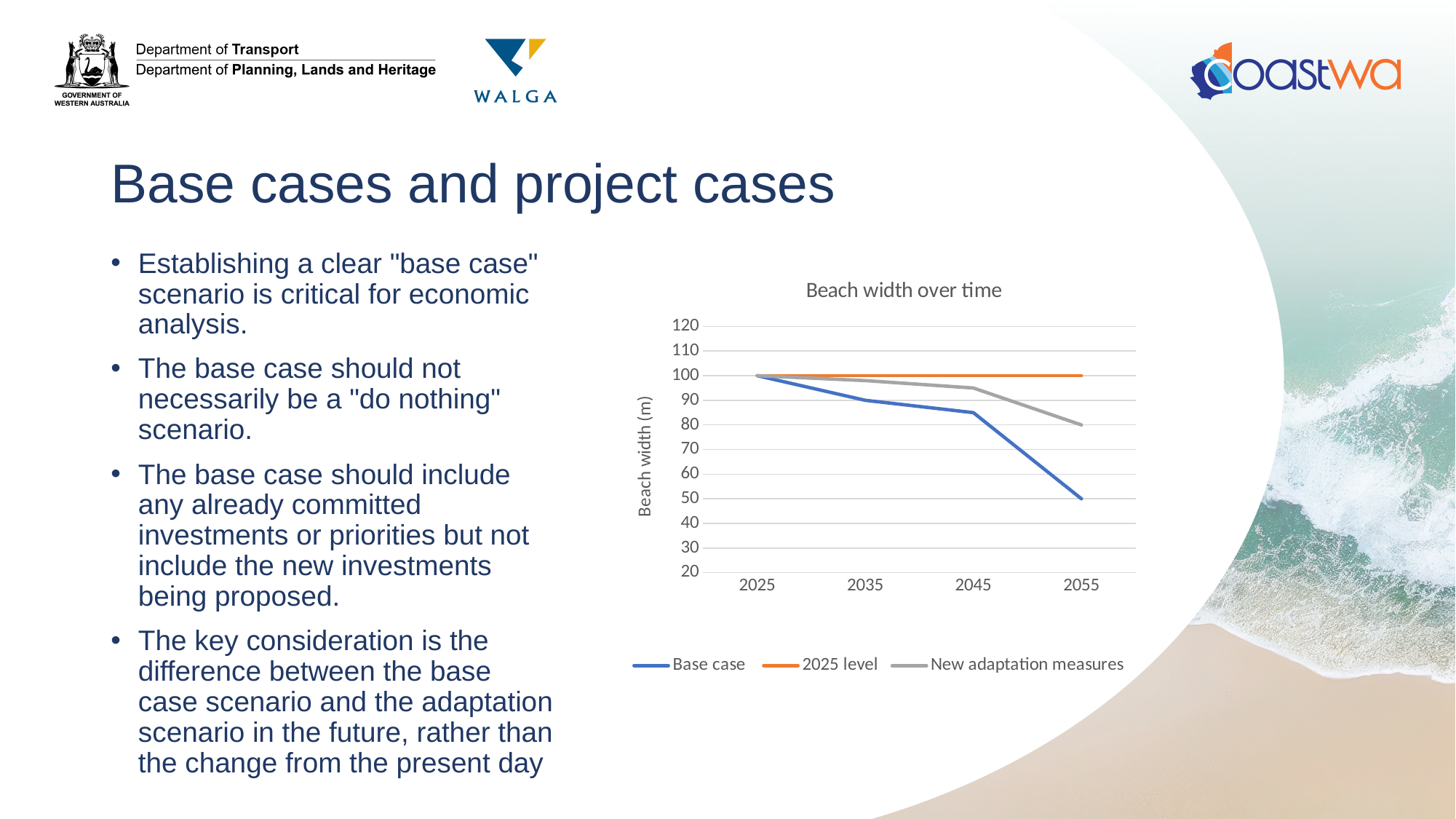
Which series has the lowest value in 2055? Base case What is the Base case beach width in 2055? 50 What is the beach width for New adaptation measures in 2055? 80 What kind of chart is shown on the slide? Line chart How many series does the chart legend list? 3 What is the title of the chart? Beach width over time What is the value of the 2025 level series in 2055? 100 Does the Base case series rise or fall from 2025 to 2055? Fall What is the difference between the New adaptation measures value and the Base case value in 2055? 30 Is the Base case value in 2045 greater or less than 80? greater What is the label of the y axis? Beach width (m) How many years are marked along the x axis of the chart? 4